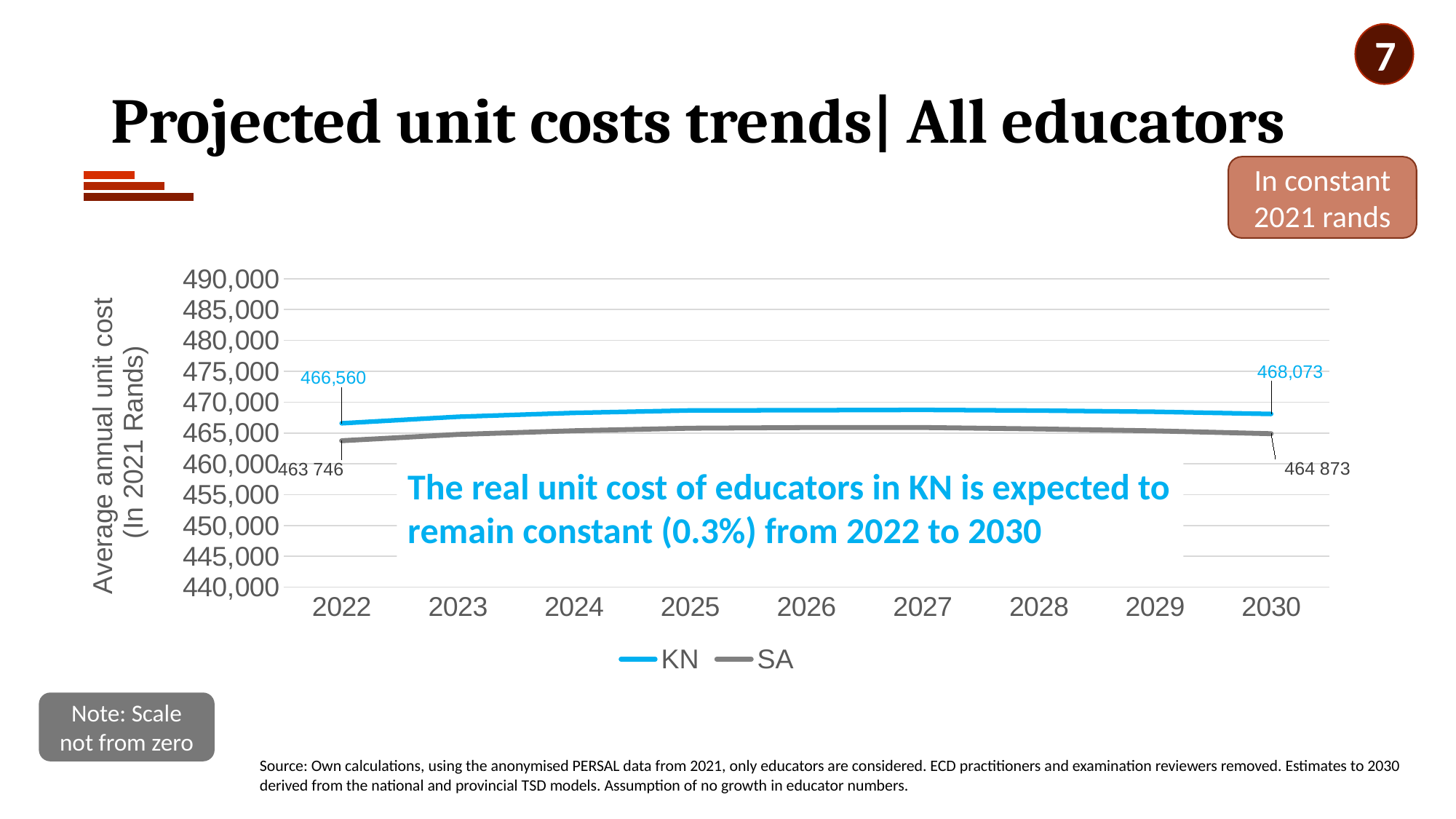
Which series has the higher value in 2030, KN or SA? KN Is the value for KN in 2026 greater or less than 465,000? greater By how much does the KN value in 2030 exceed the KN value in 2022? 1,513 What is the value for SA in 2030? 464 873 How many series does the legend list? 2 Is the value for KN in 2025 greater or less than 470,000? less What is the difference between the KN and SA values in 2022? 2,814 What is the value for KN in 2022? 466,560 What is the value for SA in 2022? 463 746 What kind of chart is shown on the slide? line chart What is the value for KN in 2030? 468,073 How many years are shown on the x axis? 9